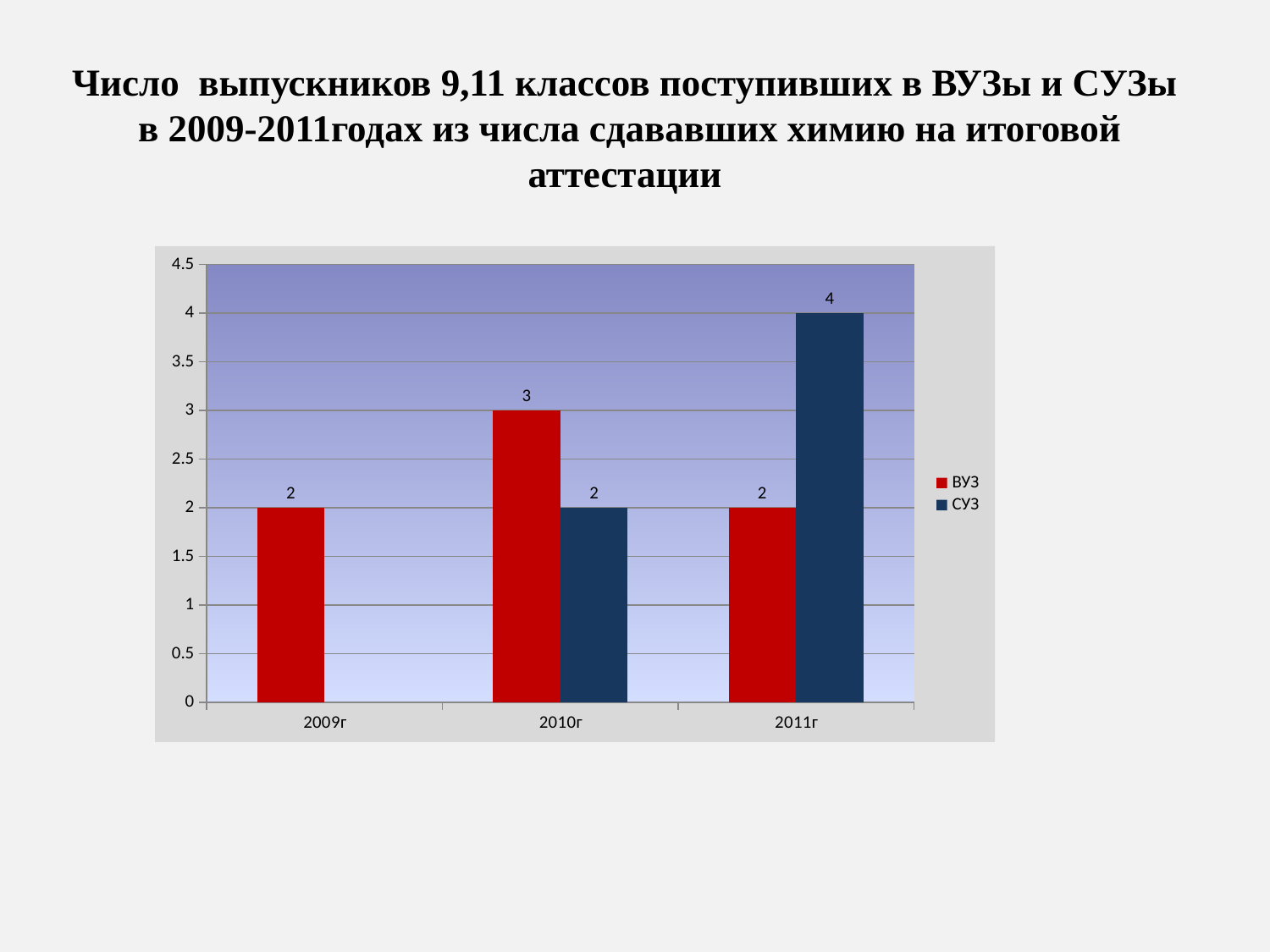
What kind of chart is shown on the slide? Bar chart What is the difference between the СУЗ value in 2011г and the ВУЗ value in 2011г? 2 What is the value for СУЗ in 2010г? 2 How many years are shown on the x axis? 3 In which year is the СУЗ value highest? 2011г In which year is the ВУЗ value highest? 2010г Which colour represents the СУЗ series? Dark blue What is the value for ВУЗ in 2009г? 2 What is the value for ВУЗ in 2010г? 3 What is the value for СУЗ in 2011г? 4 How many series does the legend list? 2 Which is larger in 2010г, ВУЗ or СУЗ? ВУЗ